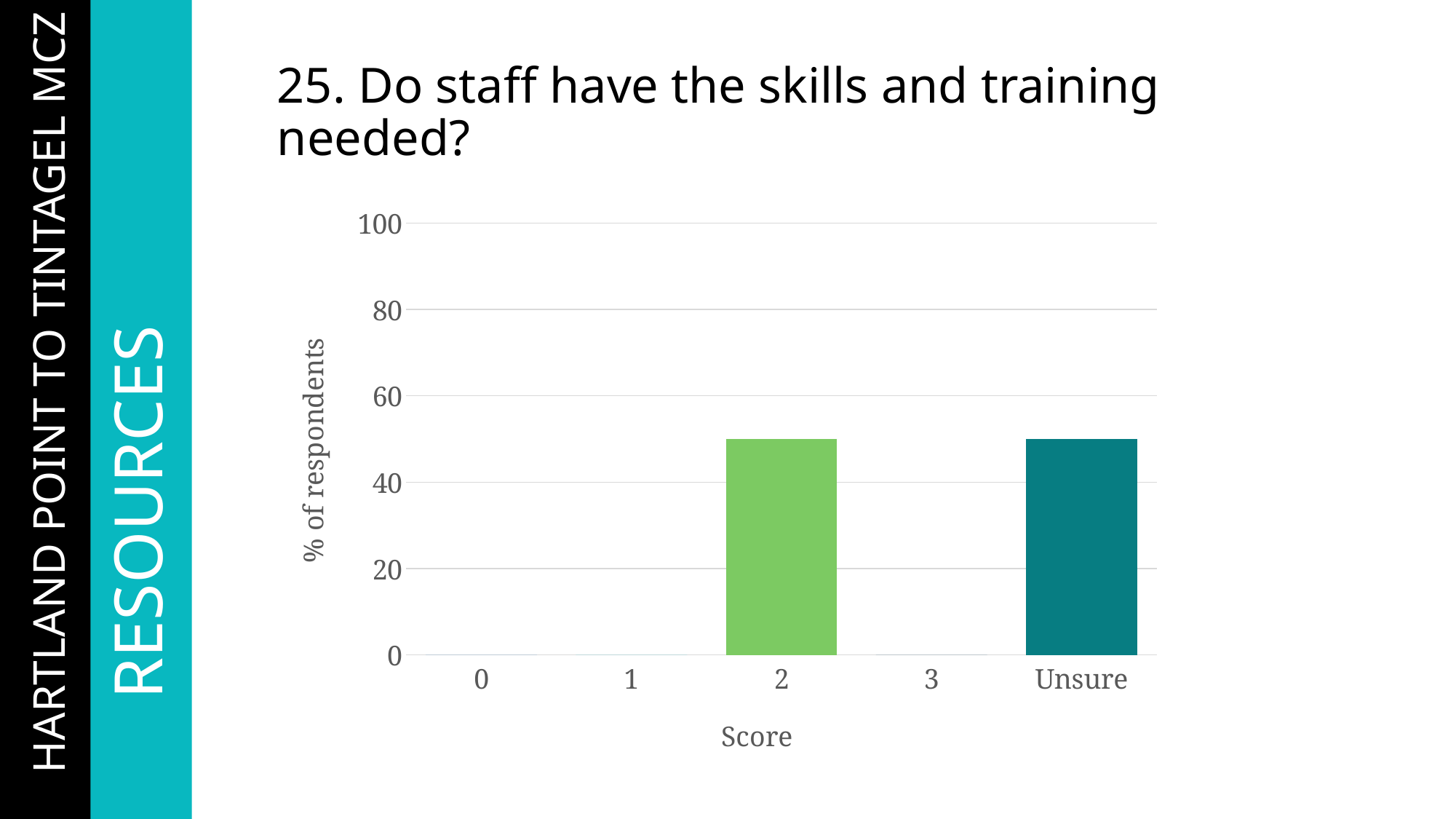
Is the value for score 2 greater or less than 60? less Is the value for Unsure greater or less than 40? greater Is the value for score 2 greater or less than 80? less What kind of chart is shown on the slide? bar chart Which is larger, the value for score 2 or the value for score 3? score 2 How many categories are shown on the x axis of the chart? 5 How many categories on the chart have a visible bar? 2 What is the label of the y axis of the chart? % of respondents Which categories on the chart have a visible bar? 2 and Unsure Which is larger, the value for Unsure or the value for score 0? Unsure